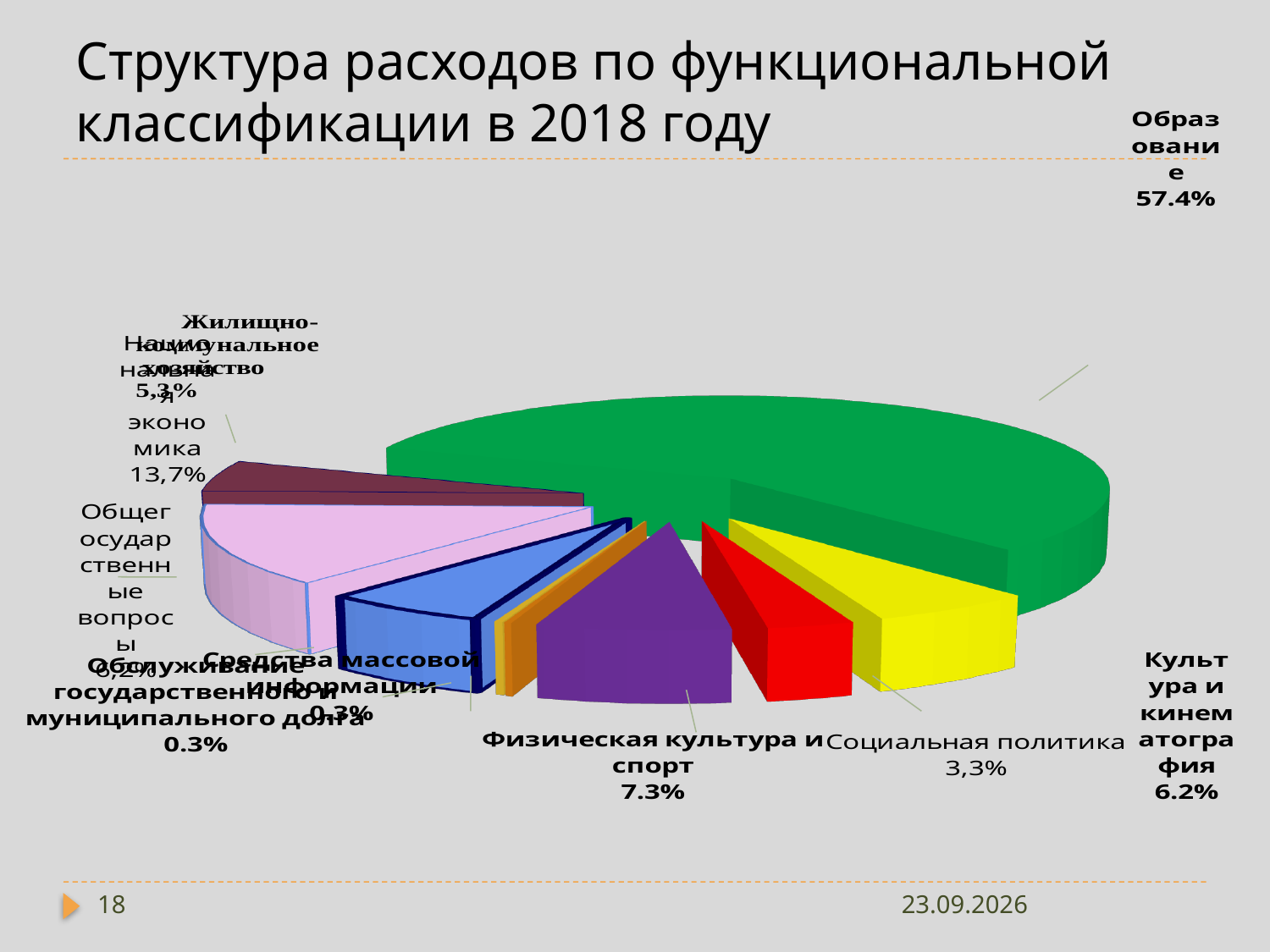
Which category has the largest share of expenditures? Образование What percentage is shown for Культура и кинематография? 6.2% What share of expenditures does Образование account for? 57.4% What year does the chart title refer to? 2018 What is the value for Социальная политика? 3,3% What percentage is shown for Национальная экономика? 13,7% What is the value shown for Физическая культура и спорт? 7.3% What colour is the slice for Образование? Green What is the value shown for Средства массовой информации? 0.3% What is the difference between Физическая культура и спорт and Культура и кинематография? 1.1% What kind of chart is shown on the slide? Pie chart Which is larger, Физическая культура и спорт or Социальная политика? Физическая культура и спорт